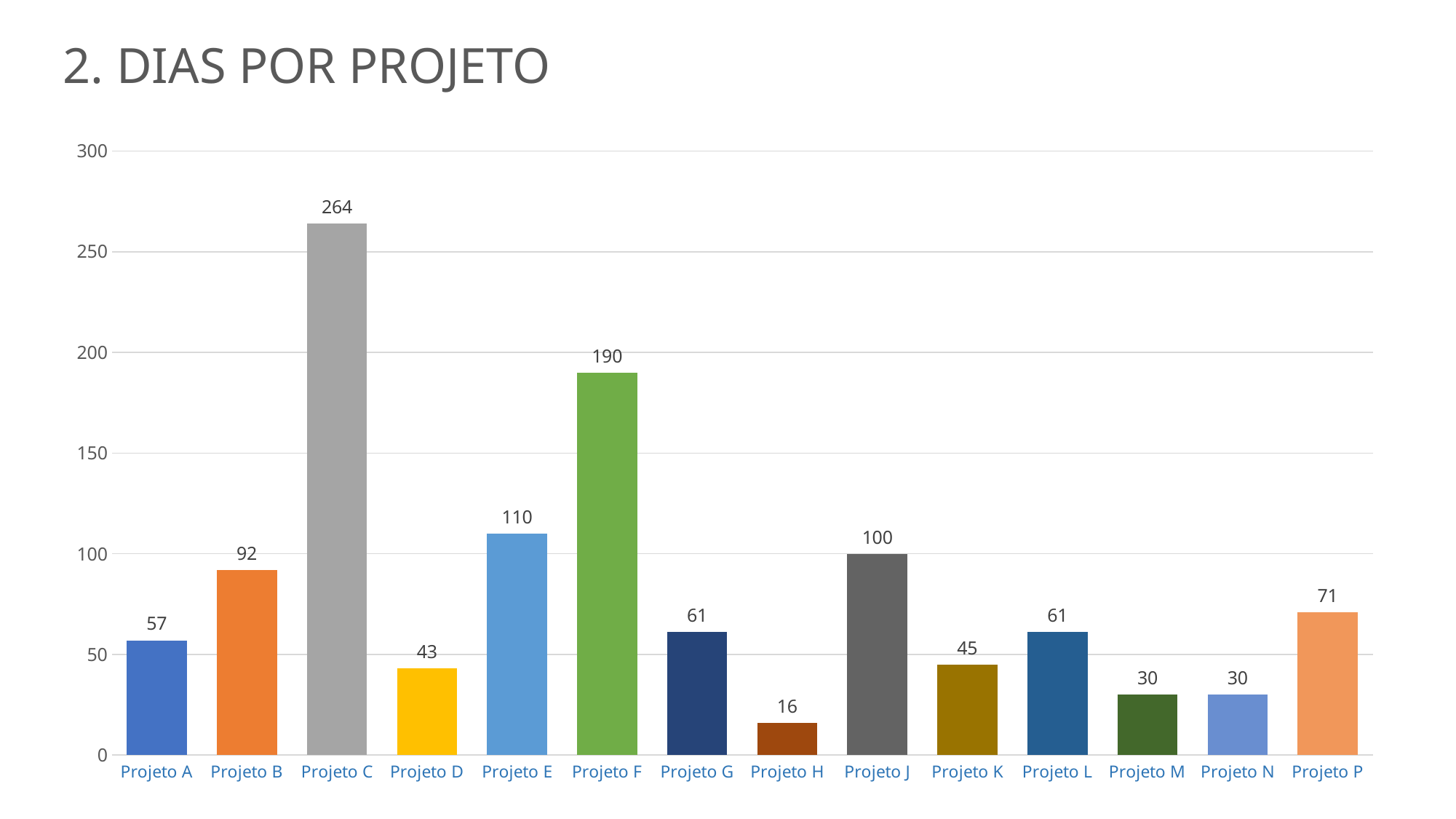
What is the difference between the values for Projeto C and Projeto F? 74 Which project has the highest value? Projeto C What kind of chart is shown on the slide? Bar chart Is the value for Projeto F greater or less than 150? greater Which project has the lowest value? Projeto H What is the title of the slide? 2. DIAS POR PROJETO What is the value for Projeto J? 100 What is the difference between the values for Projeto E and Projeto B? 18 What is the value for Projeto H? 16 How many projects are shown on the chart? 14 What is the value for Projeto C? 264 Which is larger, the value for Projeto P or the value for Projeto K? Projeto P